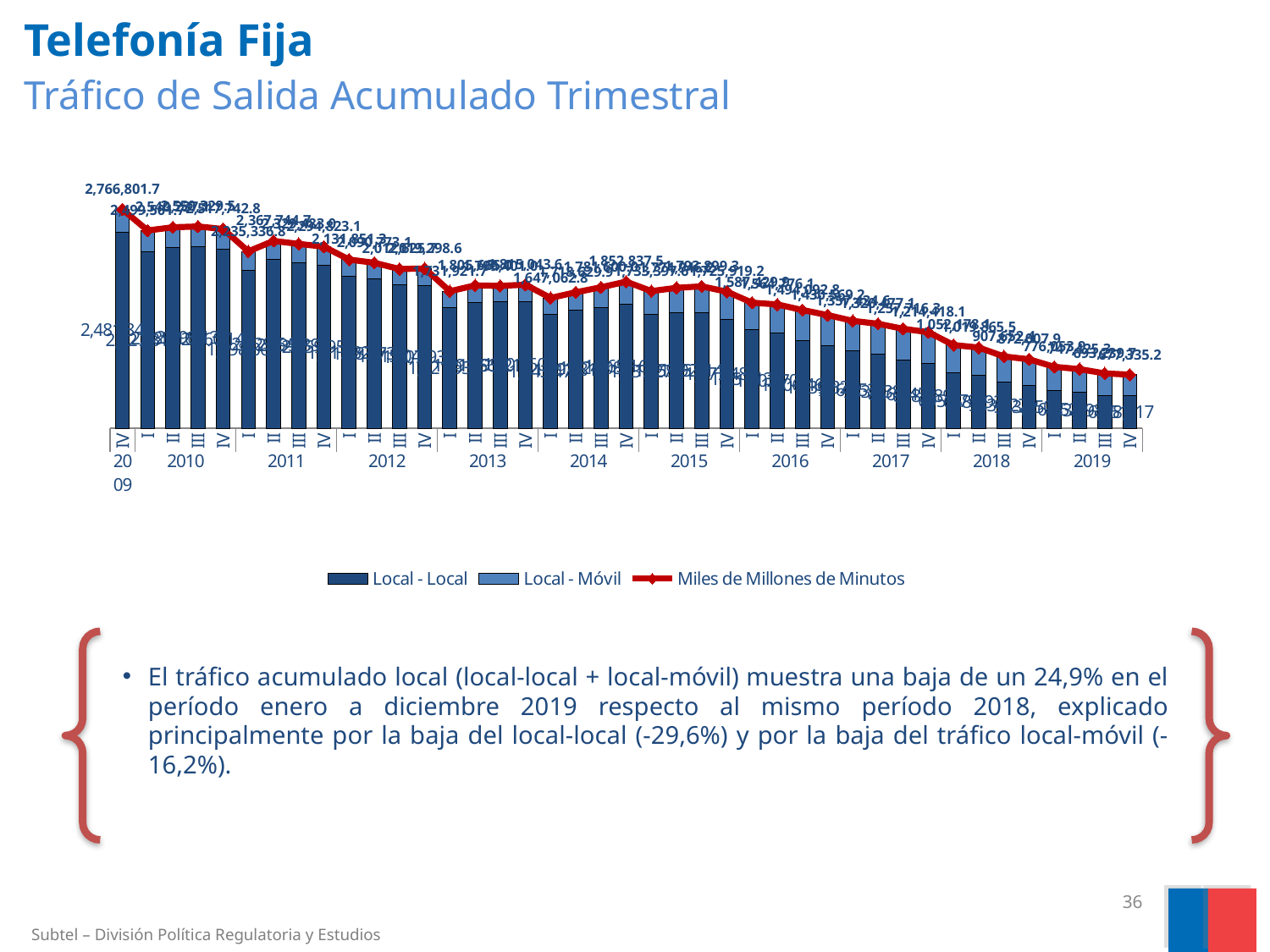
In 2019 IV, which segment is larger, Local - Local or Local - Móvil? Local - Local How many years are labelled along the x axis? 11 Which is larger, the total traffic in 2010 I or in 2019 IV? 2010 I In which quarter does the Miles de Millones de Minutos line reach its lowest value? 2019 IV What is the value of the first data label on the line, at 2009 IV? 2,766,801.7 What colour is the Miles de Millones de Minutos line? Red What kind of chart is shown on the slide? A stacked bar chart with a line overlay Which is larger, the total traffic in 2014 I or in 2018 I? 2014 I Does the Miles de Millones de Minutos line rise or fall from 2009 to 2019? It falls How many series does the legend list? 3 In which quarter does the Miles de Millones de Minutos line reach its highest value? 2009 IV What are the three entries in the chart legend? Local - Local, Local - Móvil, Miles de Millones de Minutos